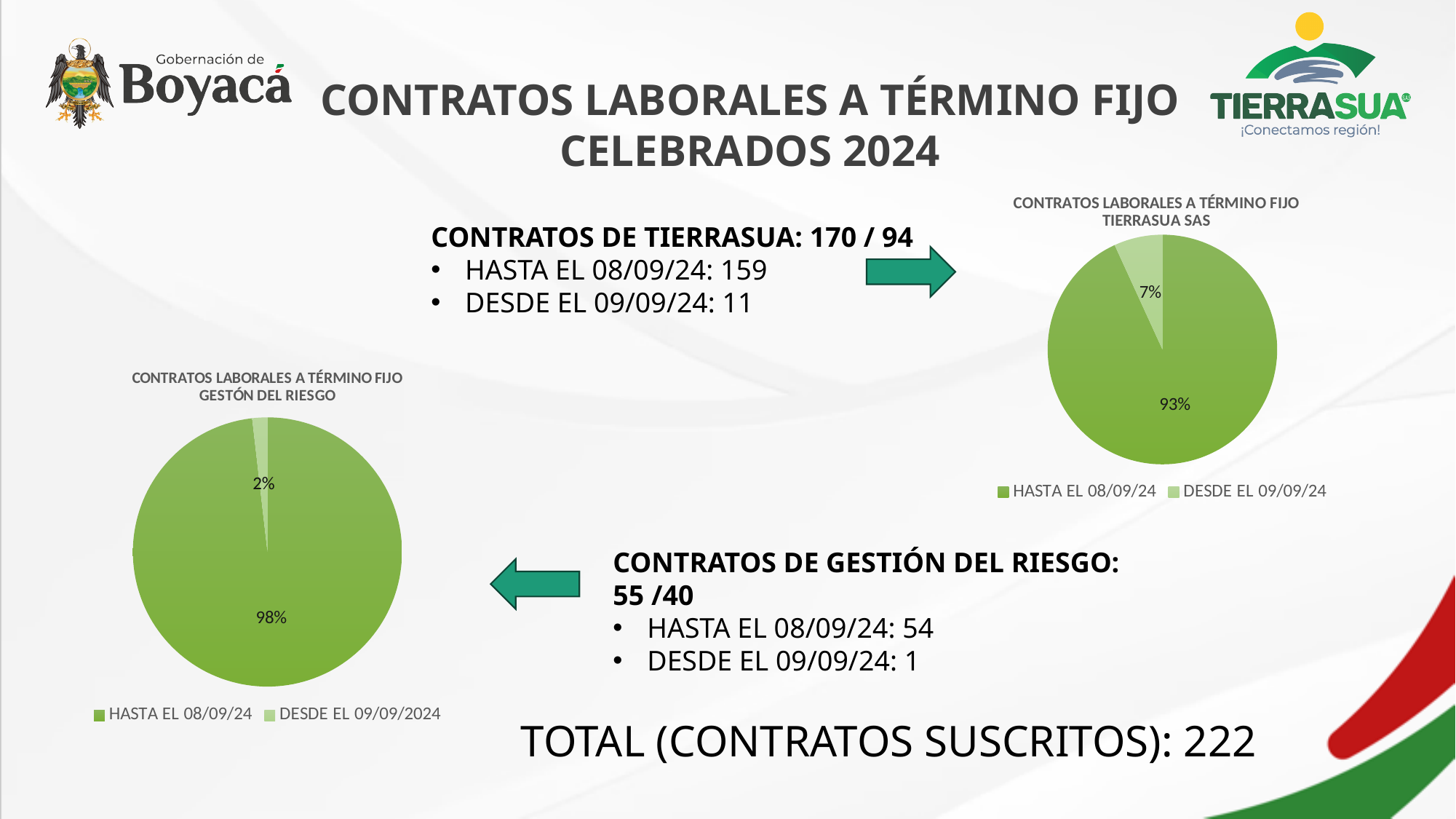
In the 'CONTRATOS LABORALES A TÉRMINO FIJO GESTÓN DEL RIESGO' pie chart, what share is labelled for DESDE EL 09/09/2024? 2% In the 'CONTRATOS LABORALES A TÉRMINO FIJO GESTÓN DEL RIESGO' pie chart, what is the difference in percentage points between the two slices? 96 In the 'CONTRATOS LABORALES A TÉRMINO FIJO GESTÓN DEL RIESGO' pie chart, what share is labelled for HASTA EL 08/09/24? 98% In the 'CONTRATOS LABORALES A TÉRMINO FIJO TIERRASUA SAS' pie chart, which slice is the largest? HASTA EL 08/09/24 How many slices does the 'CONTRATOS LABORALES A TÉRMINO FIJO TIERRASUA SAS' pie chart have? 2 In the 'CONTRATOS LABORALES A TÉRMINO FIJO TIERRASUA SAS' pie chart, what share is labelled for HASTA EL 08/09/24? 93% Which is larger: the DESDE EL 09/09/24 share in the TIERRASUA SAS pie chart or the DESDE EL 09/09/2024 share in the GESTÓN DEL RIESGO pie chart? TIERRASUA SAS (7%) What kind of chart is the 'CONTRATOS LABORALES A TÉRMINO FIJO TIERRASUA SAS' chart? Pie chart What is the title of the pie chart on the right side of the slide? CONTRATOS LABORALES A TÉRMINO FIJO TIERRASUA SAS In the 'CONTRATOS LABORALES A TÉRMINO FIJO GESTÓN DEL RIESGO' pie chart, which slice is the smallest? DESDE EL 09/09/2024 How many entries does the legend of the 'CONTRATOS LABORALES A TÉRMINO FIJO GESTÓN DEL RIESGO' pie chart list? 2